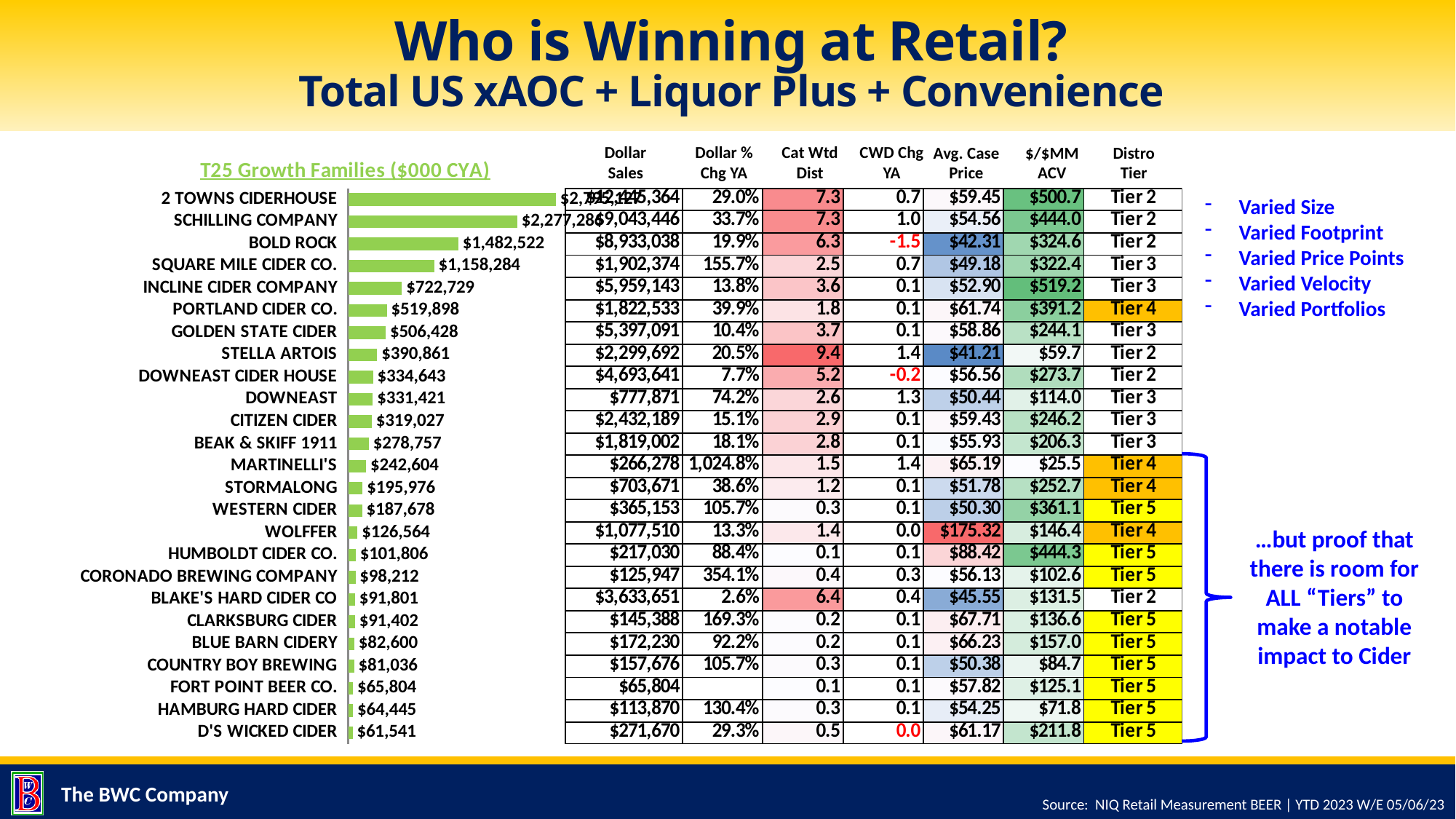
What is the value shown for BOLD ROCK in the bar chart? $1,482,522 What is the value shown for SQUARE MILE CIDER CO. in the bar chart? $1,158,284 Which family has the shortest bar in the chart? D'S WICKED CIDER What is the value shown for MARTINELLI'S in the bar chart? $242,604 How many families (categories) are plotted in the bar chart? 25 Which family has the longest bar in the chart? 2 TOWNS CIDERHOUSE What is the title of the chart on the slide? T25 Growth Families ($000 CYA) Which has the larger value in the bar chart, STELLA ARTOIS or DOWNEAST CIDER HOUSE? STELLA ARTOIS What is the difference between the values for BOLD ROCK and SQUARE MILE CIDER CO. in the bar chart? $324,238 Do the bar values increase or decrease going from the top of the chart to the bottom? decrease What is the value shown for INCLINE CIDER COMPANY in the bar chart? $722,729 What kind of chart is shown on the slide? bar chart